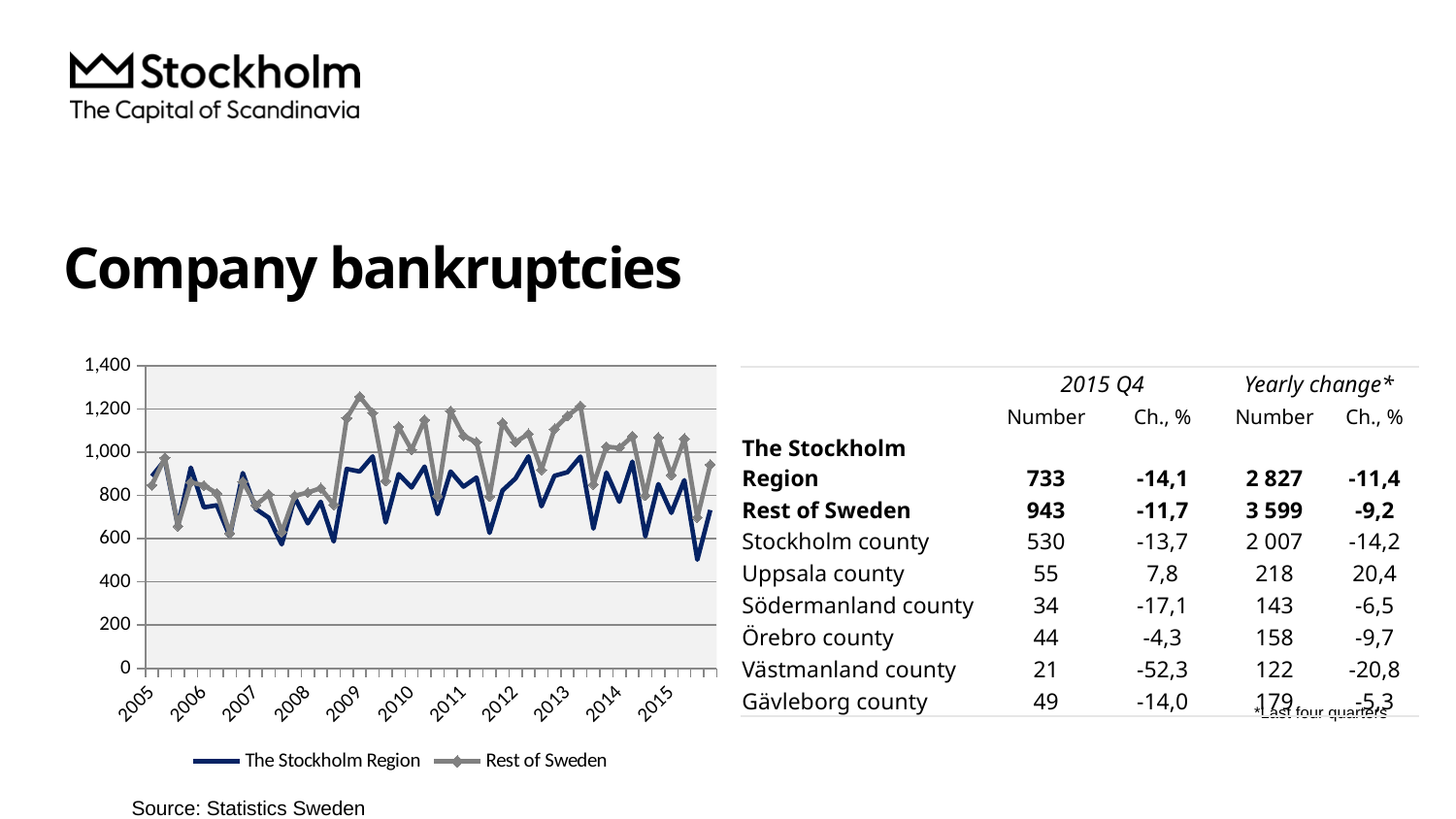
How many years are labelled along the chart's x axis? 11 What is the highest value shown on the chart's vertical axis? 1,400 What are the two series named in the chart legend? The Stockholm Region and Rest of Sweden Is the lowest value for The Stockholm Region in 2015 greater or less than 600? less What kind of chart is shown on the slide? line chart Does the Rest of Sweden series rise or fall overall from 2008 to 2009? rise Is the lowest value for Rest of Sweden in 2006 greater or less than 800? less Which series is drawn with diamond markers in the chart? Rest of Sweden How many series does the chart legend list? 2 At the 2009 peak, which series has the higher value, The Stockholm Region or Rest of Sweden? Rest of Sweden Is the peak value for Rest of Sweden in 2009 greater or less than 1,200? greater